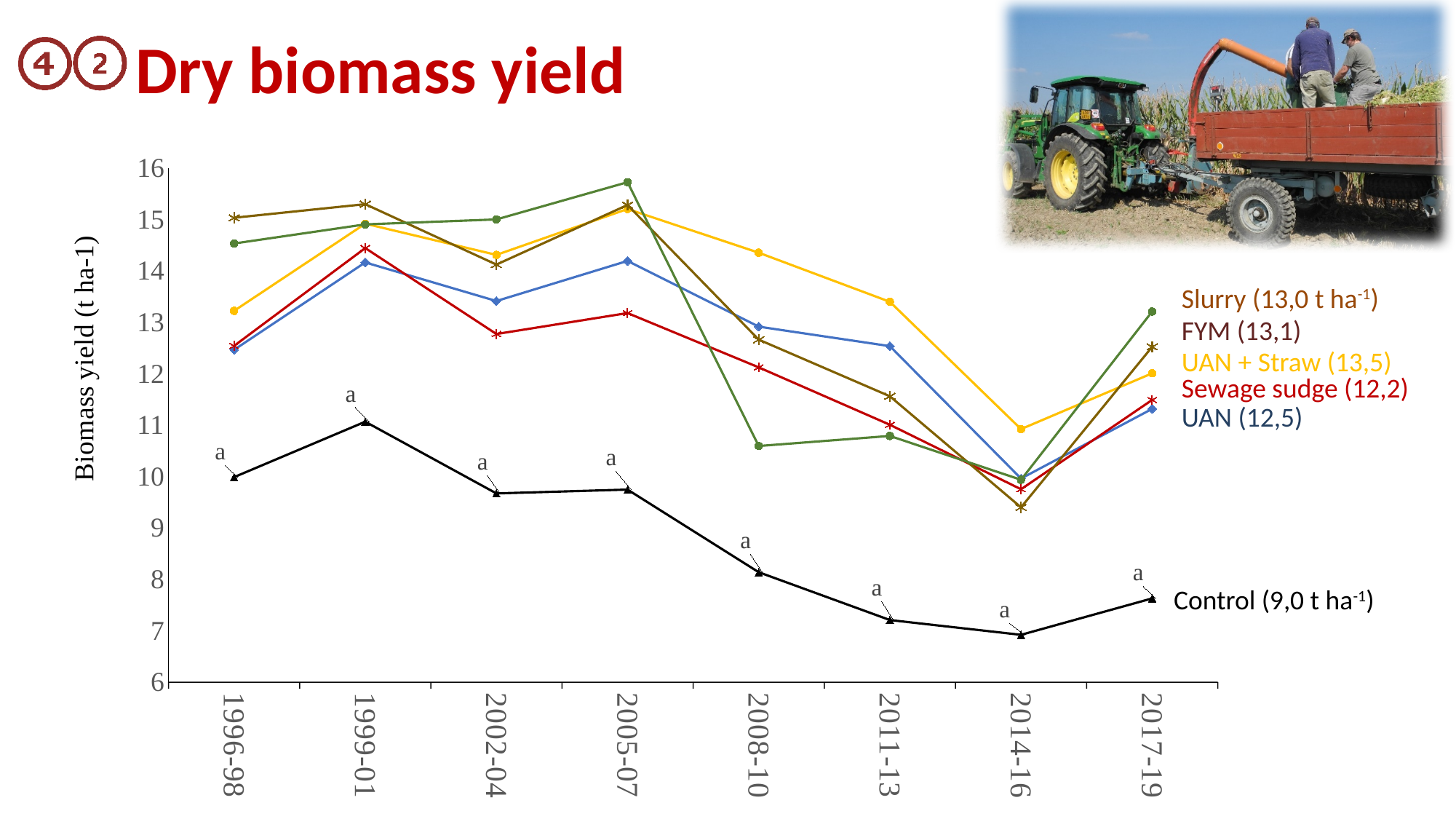
What is the difference between the average yields given for UAN + Straw and Control? 4,5 Which treatment has the highest average yield given in the labels? UAN + Straw How many time periods are shown on the x axis? 8 Which treatment has the lowest average yield given in the labels? Control What kind of chart is shown on the slide? line chart What average value is given for the Sewage sludge treatment? 12,2 In 2008-10, which is higher: UAN + Straw or Slurry? UAN + Straw What average dry biomass yield is given for the Control treatment? 9,0 t ha-1 How many treatment series are plotted on the chart? 6 Is the value for Slurry in 2005-07 greater or less than 15? greater What average value is given for the UAN + Straw treatment? 13,5 Is the value for Control in 2011-13 greater or less than 8? less